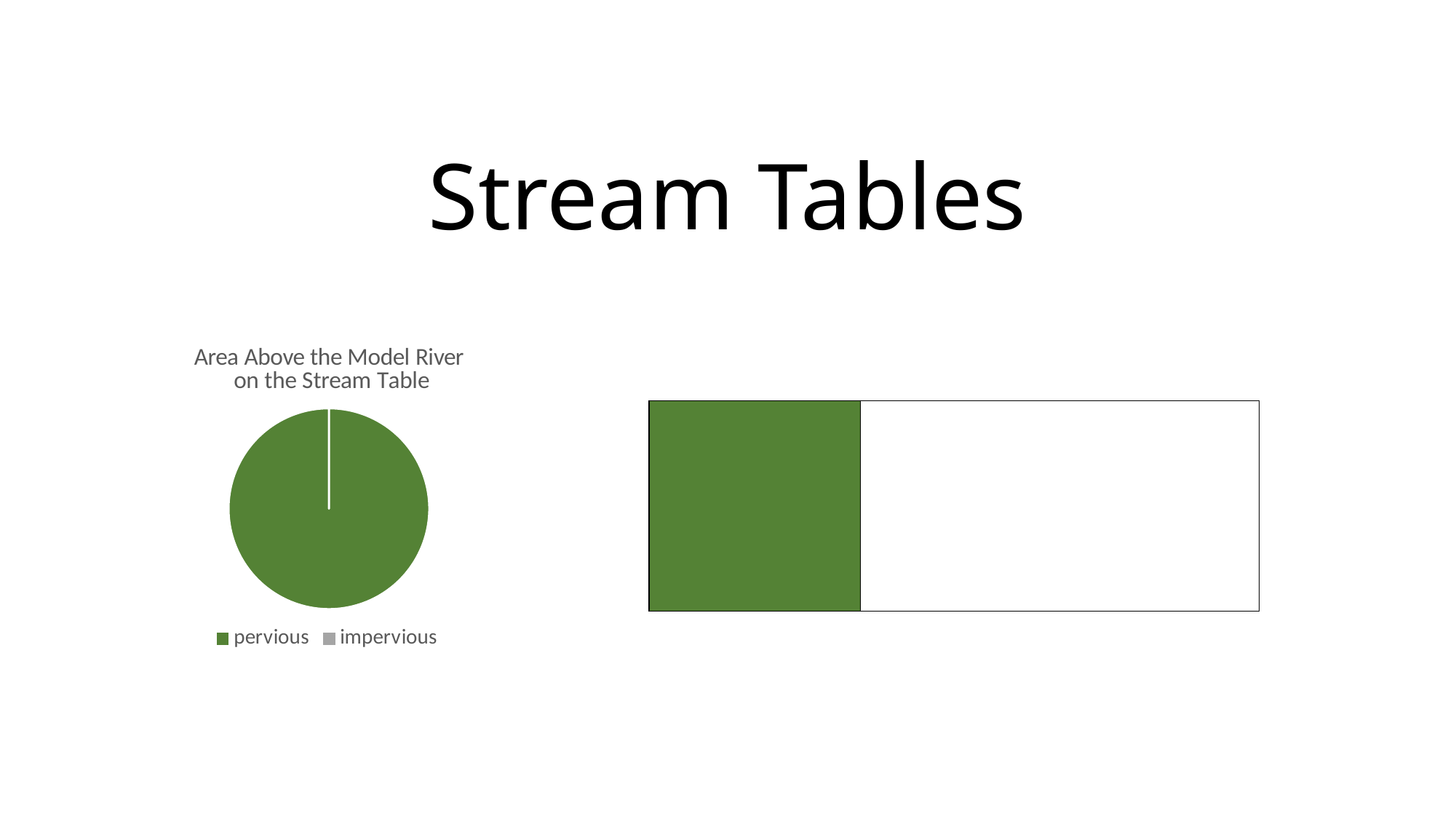
How many categories does the legend of the pie chart list? 2 What kind of chart is shown on the slide? pie chart Which is larger in the pie chart, pervious or impervious? pervious What is the title of the pie chart? Area Above the Model River on the Stream Table Which category takes up the smallest share of the pie chart? impervious Which category takes up the largest share of the pie chart? pervious What colour represents the pervious category in the pie chart? green